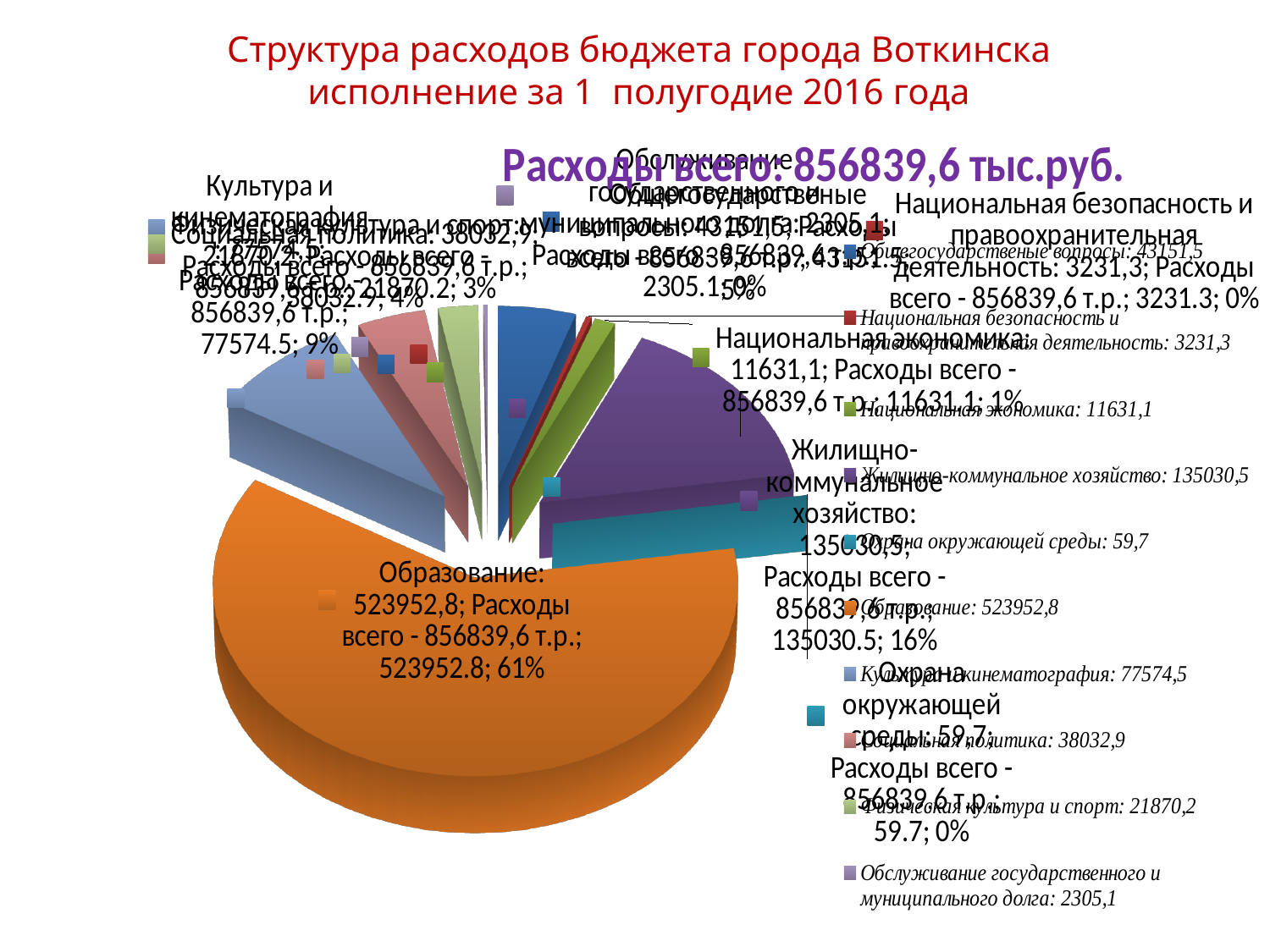
Which is larger: the value for Социальная политика or the value for Физическая культура и спорт? Социальная политика What percentage share of the pie does Культура и кинематография account for? 9% What percentage share of the pie does Образование account for? 61% Which category has the largest share of expenditures in the pie chart? Образование What is the value for Жилищно-коммунальное хозяйство? 135030,5 What kind of chart is shown on the slide? Pie chart What is the value for Образование in the pie chart? 523952,8 What is the value for Национальная безопасность и правоохранительная деятельность? 3231,3 What is the difference between the values for Образование and Жилищно-коммунальное хозяйство? 388922,3 How many categories does the legend of the pie chart list? 10 What total expenditure amount is stated in the chart title? 856839,6 тыс.руб. Which category has the smallest value in the pie chart? Охрана окружающей среды